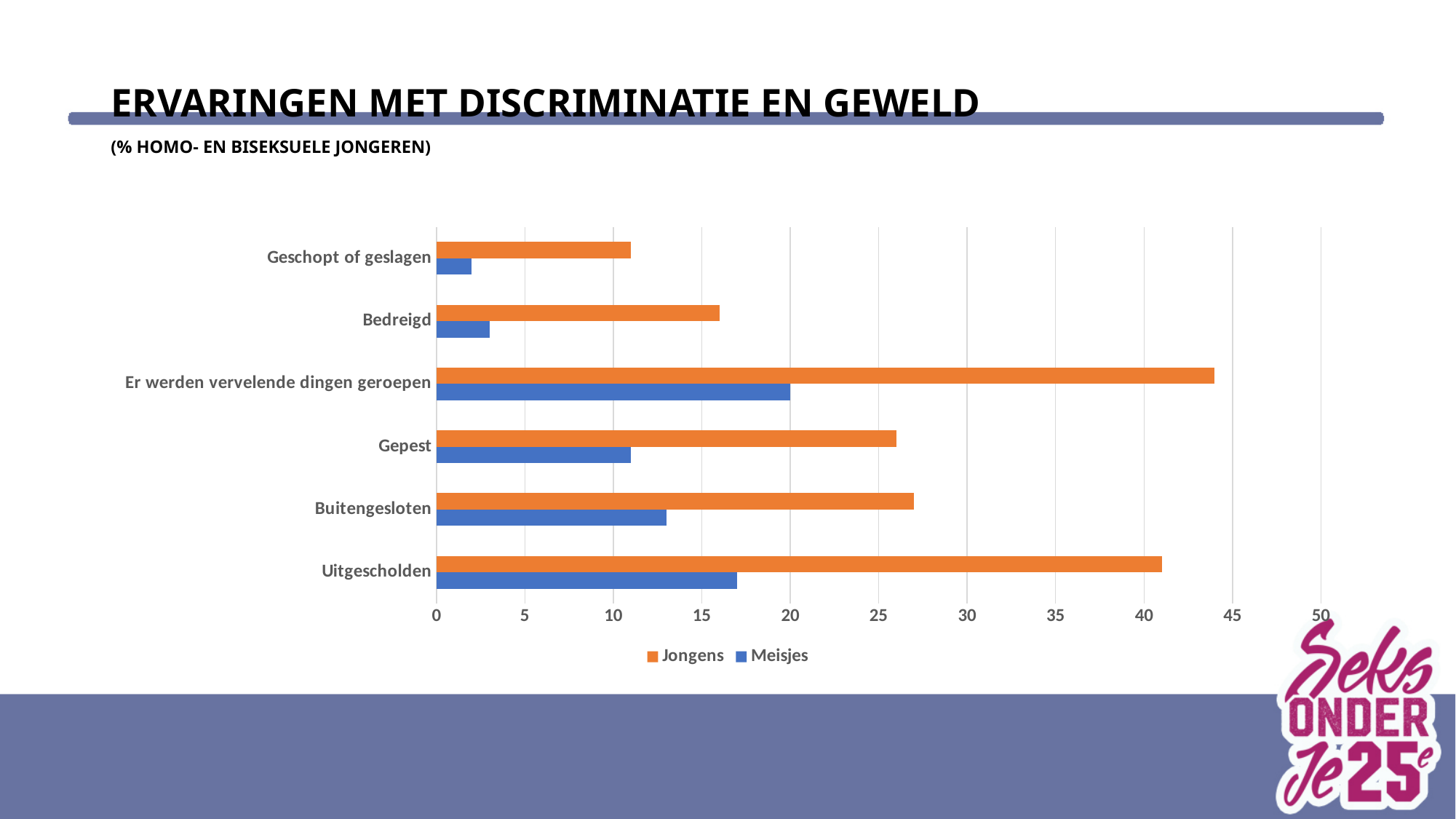
What kind of chart is shown on the slide? bar chart Which category has the lowest value for Jongens? Geschopt of geslagen How many series does the legend list? 2 How many categories are shown on the chart? 6 Is the value for Meisjes in the category Bedreigd greater or less than 5? less Which category has the highest value for Meisjes? Er werden vervelende dingen geroepen Which is larger: the Meisjes value for Uitgescholden or the Meisjes value for Gepest? Uitgescholden Is the value for Jongens in the category Gepest greater or less than 25? greater Which is larger for the category Buitengesloten: the value for Jongens or the value for Meisjes? Jongens Which colour represents the Meisjes series in the chart? blue Which category has the highest value for Jongens? Er werden vervelende dingen geroepen Is the value for Jongens in the category Uitgescholden greater or less than 40? greater